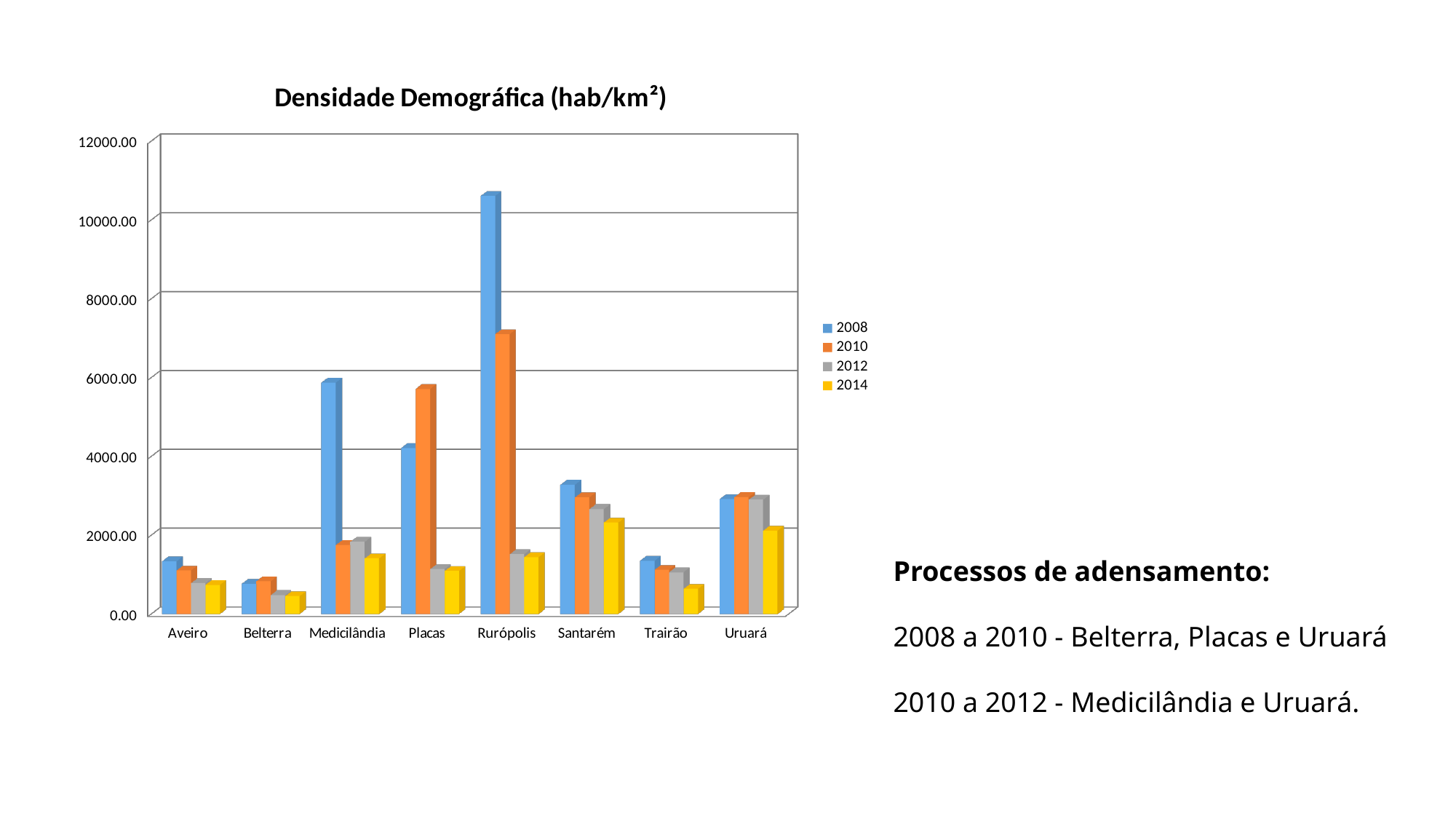
Which municipality has the lowest value for 2014? Belterra How many municipalities are shown on the x axis of the chart? 8 Is the 2008 value for Rurópolis greater or less than 10000.00? greater Which municipality has the highest value for 2008? Rurópolis What is the title of the chart? Densidade Demográfica (hab/km²) Is the 2010 value for Rurópolis greater or less than 6000.00? greater How many series does the legend of the chart list? 4 For Placas, which year has the larger value, 2008 or 2010? 2010 What kind of chart is shown on the slide? bar chart Which has the larger 2008 value, Medicilândia or Placas? Medicilândia Do the values for Santarém rise or fall from 2008 to 2014? fall Is the 2008 value for Medicilândia greater or less than 4000.00? greater